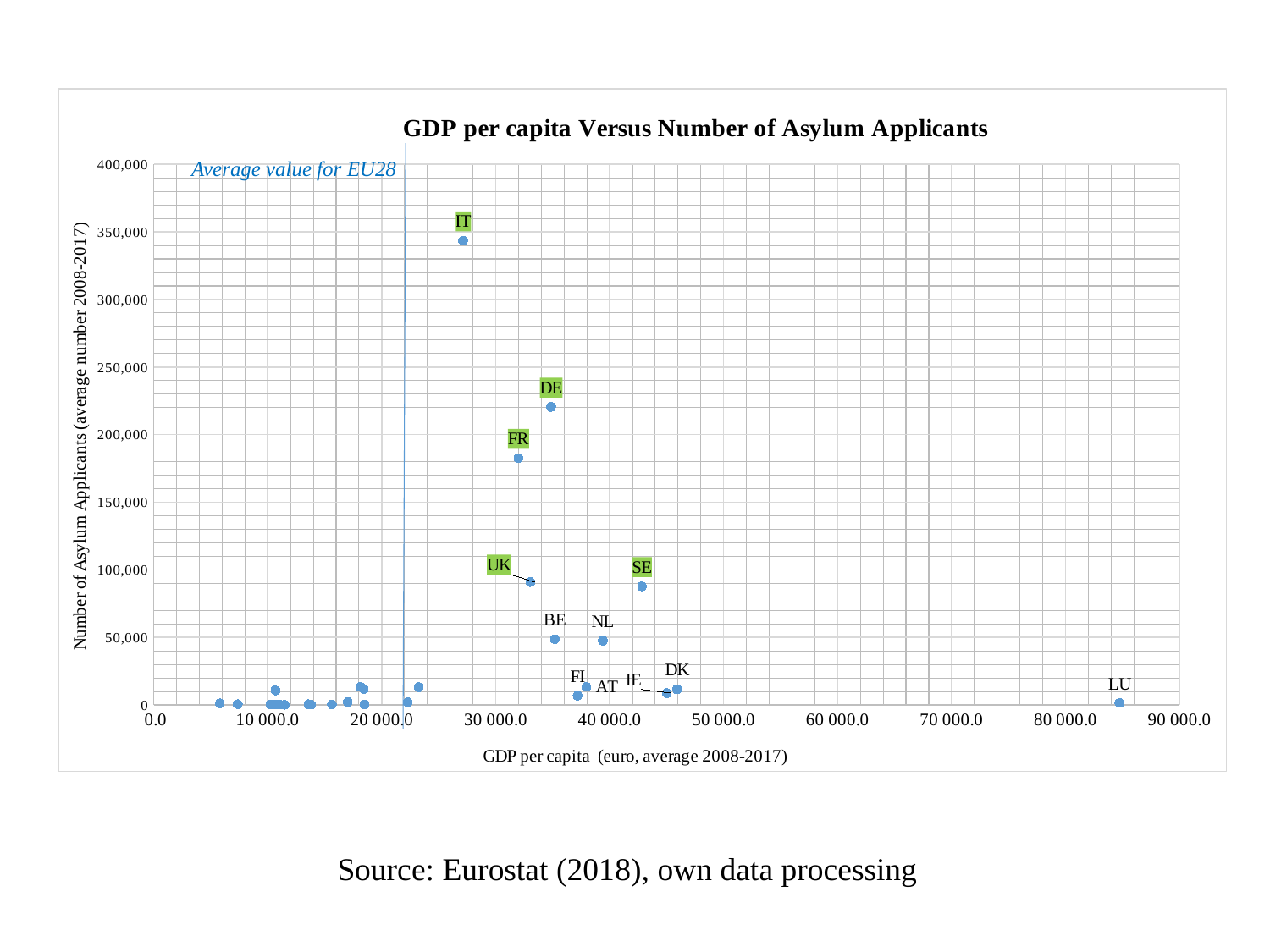
Is the number of asylum applicants for IT greater or less than 300,000? greater Is the number of asylum applicants for SE greater or less than 100,000? less What kind of chart is shown on the slide? scatter chart Which country has more asylum applicants, DE or FR? DE Which labeled country has the highest number of asylum applicants? IT Which labeled country has the highest GDP per capita? LU Which country has a higher GDP per capita, SE or UK? SE Is the number of asylum applicants for FR greater or less than 200,000? less What is the title of the chart? GDP per capita Versus Number of Asylum Applicants What does the vertical blue line on the chart represent? Average value for EU28